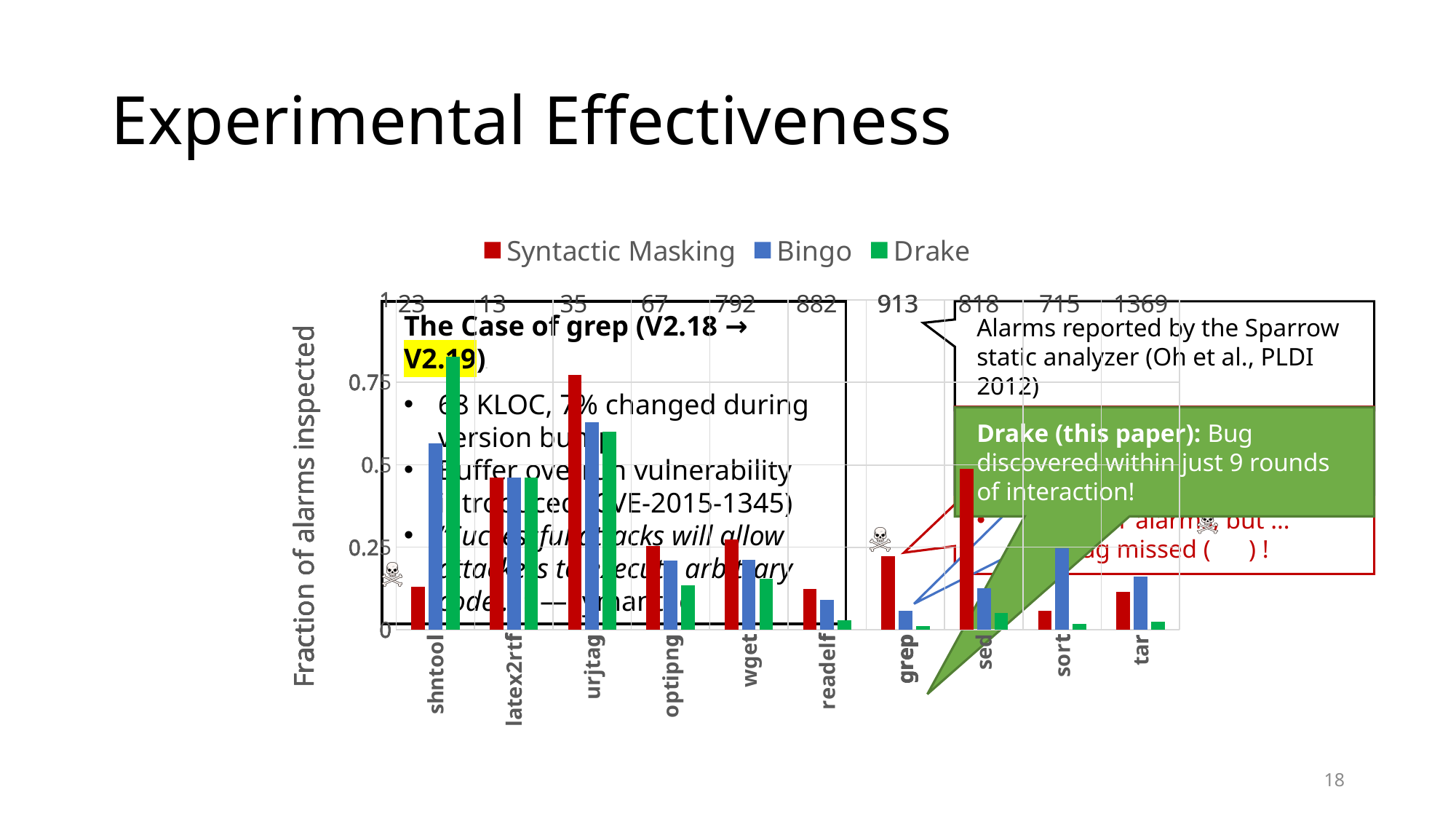
What kind of chart is shown on the slide? bar chart For shntool, which is larger: the Drake value or the Syntactic Masking value? Drake How many series does the legend list? 3 Is the Bingo value for grep greater or less than 0.25? less For sort, which is larger: the Bingo value or the Syntactic Masking value? Bingo How many programs (categories) are shown on the x axis? 10 Is the Syntactic Masking value for sed greater or less than 0.25? greater What are the three series named in the legend? Syntactic Masking, Bingo, Drake Is the Drake value for shntool greater or less than 0.75? greater Which program has the highest Syntactic Masking bar? urjtag What is the label of the y axis? Fraction of alarms inspected